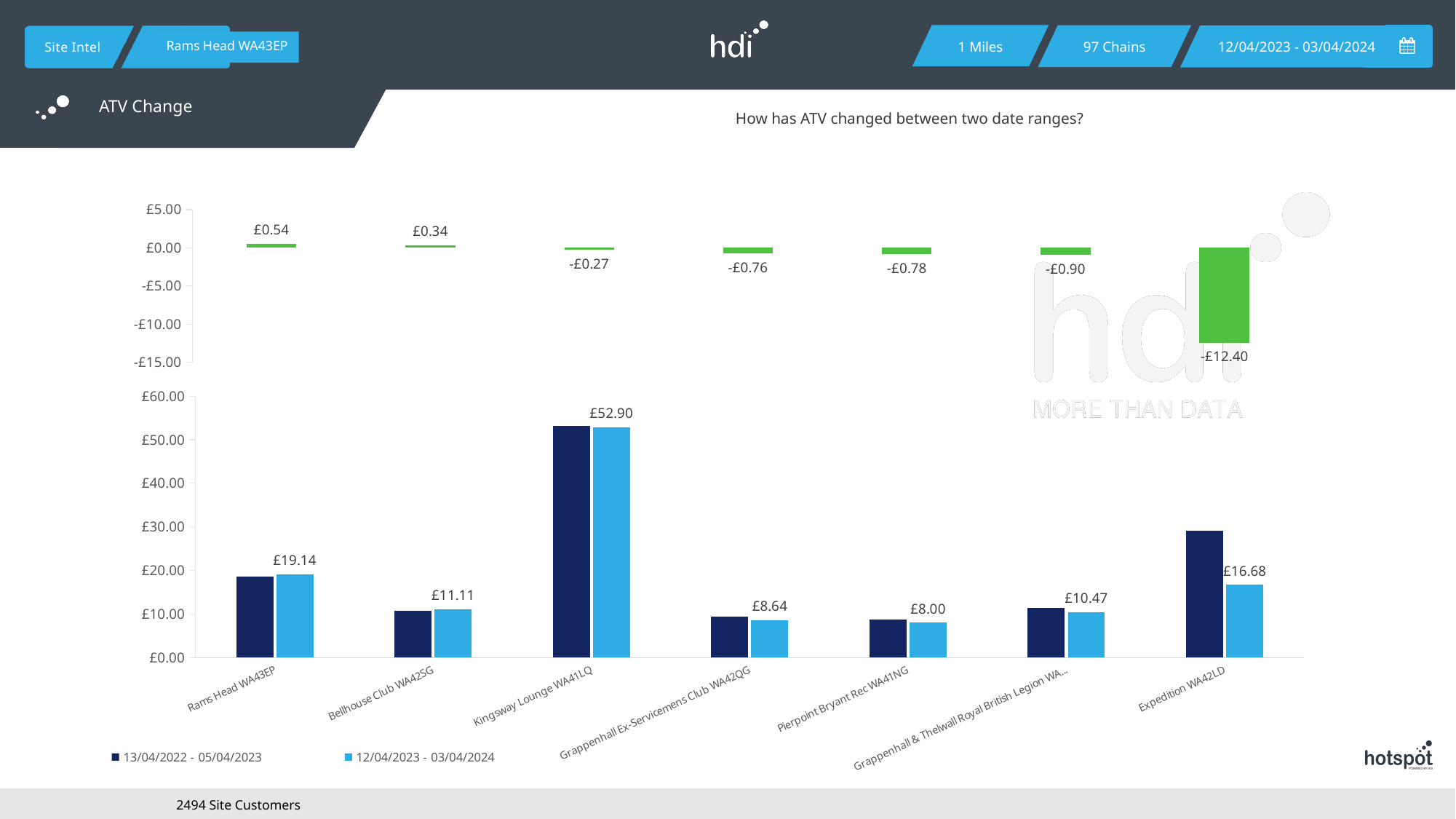
In the top chart (ATV change), which category has the lowest value? Expedition WA42LD In the bottom chart, what is the value for Kingsway Lounge WA41LQ in the 12/04/2023 - 03/04/2024 series? £52.90 In the bottom chart, is the value for Expedition WA42LD in the 13/04/2022 - 05/04/2023 series greater or less than £20.00? greater How many series does the legend of the bottom chart list? 2 In the top chart (ATV change), which category has the highest value? Rams Head WA43EP In the top chart (ATV change), what is the value for Rams Head WA43EP? £0.54 In the bottom chart, which category has the highest value in the 12/04/2023 - 03/04/2024 series? Kingsway Lounge WA41LQ In the top chart (ATV change), what is the value for Expedition WA42LD? -£12.40 In the bottom chart, what is the value for Pierpoint Bryant Rec WA41NG in the 12/04/2023 - 03/04/2024 series? £8.00 In the bottom chart, which is larger for Expedition WA42LD: the 13/04/2022 - 05/04/2023 value or the 12/04/2023 - 03/04/2024 value? 13/04/2022 - 05/04/2023 What type of chart is the bottom chart? Bar chart In the top chart (ATV change), what is the difference between the values for Rams Head WA43EP and Bellhouse Club WA42SG? £0.20